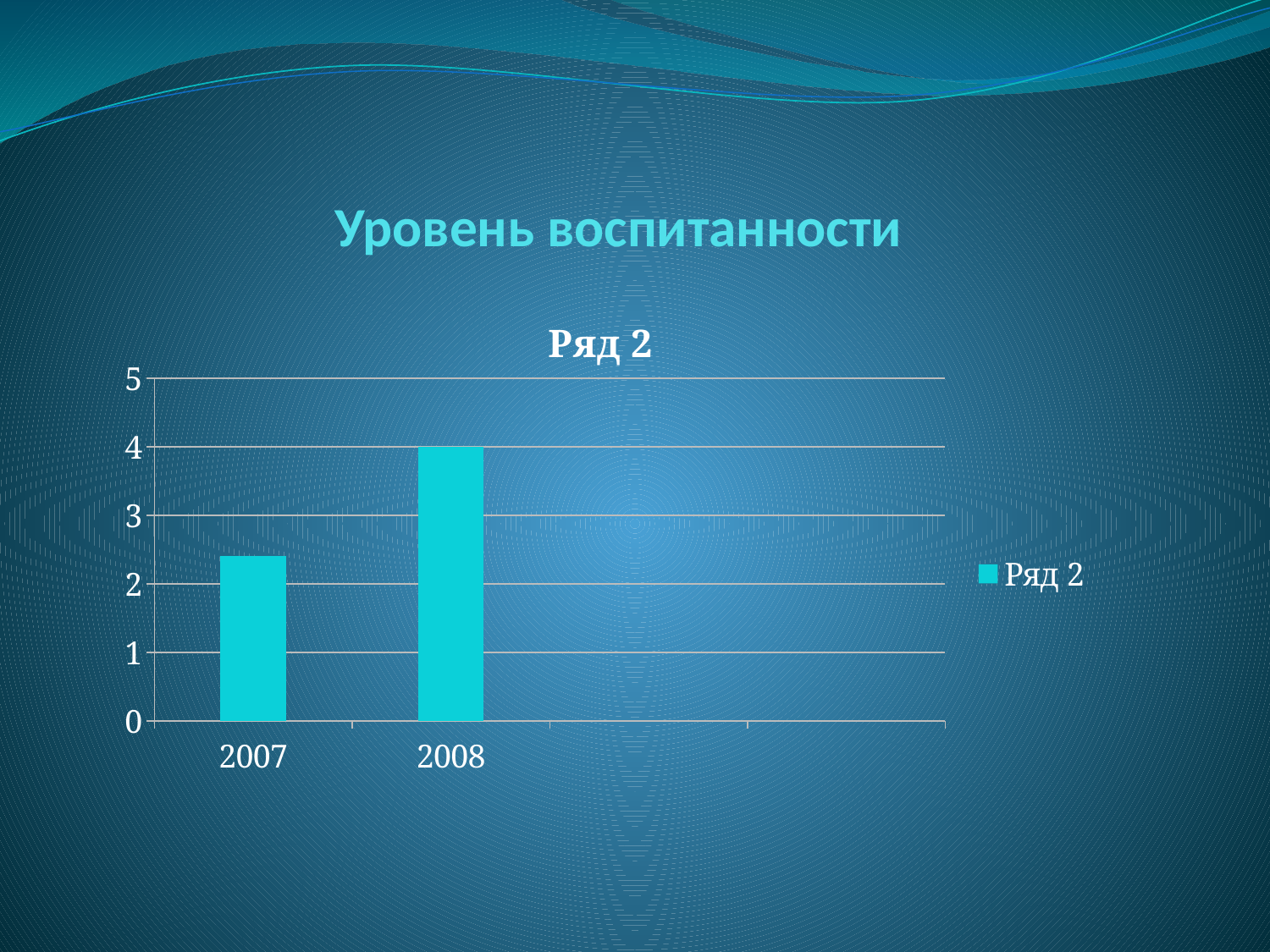
What kind of chart is shown on the slide? bar chart Which year has the highest bar in the chart? 2008 How many categories are plotted on the x axis of the chart? 2 Do the values rise or fall from 2007 to 2008? rise Is the value for 2007 greater or less than 2? greater Which is larger, the value for 2007 or the value for 2008? 2008 What is the name of the series listed in the chart legend? Ряд 2 What is the title shown above the chart? Ряд 2 Is the value for 2007 greater or less than 3? less What is the value for 2008 in the chart? 4 Which year has the lowest bar in the chart? 2007 How many series does the chart legend list? 1